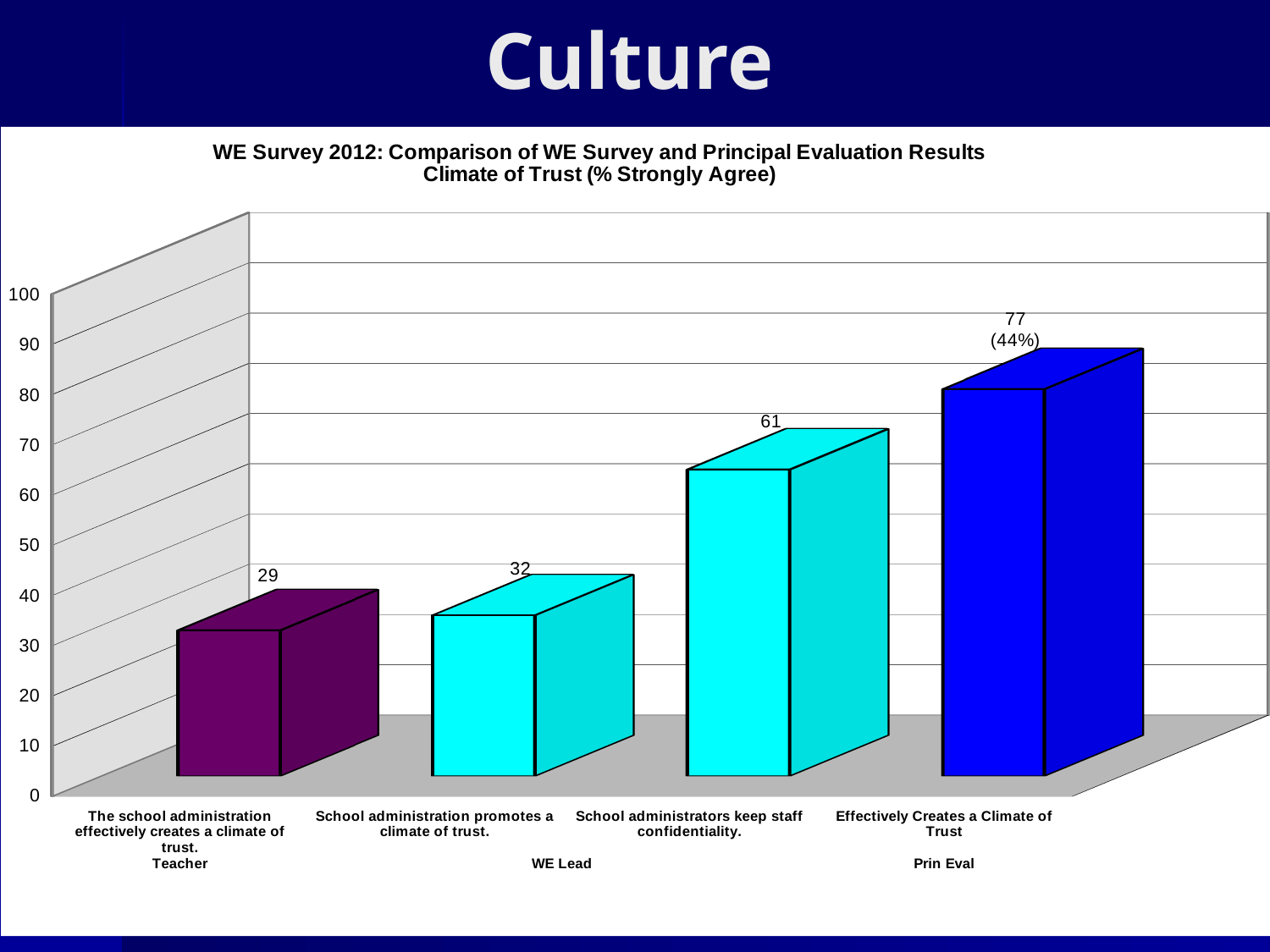
What kind of chart is shown on the slide? Bar chart Which category has the lowest value? The school administration effectively creates a climate of trust. How many bars are shown in the chart? 4 Which category has the highest value? Effectively Creates a Climate of Trust What is the value for "Effectively Creates a Climate of Trust"? 77 What is the value for "School administration promotes a climate of trust."? 32 Do the values rise or fall from left to right across the categories? Rise Which is larger: the value for "School administration promotes a climate of trust." or "The school administration effectively creates a climate of trust."? School administration promotes a climate of trust. What percentage is shown in parentheses under the 77 data label? 44% What is the value for "School administrators keep staff confidentiality."? 61 What is the difference between the values for "Effectively Creates a Climate of Trust" and "School administrators keep staff confidentiality."? 16 What is the value for "The school administration effectively creates a climate of trust."? 29